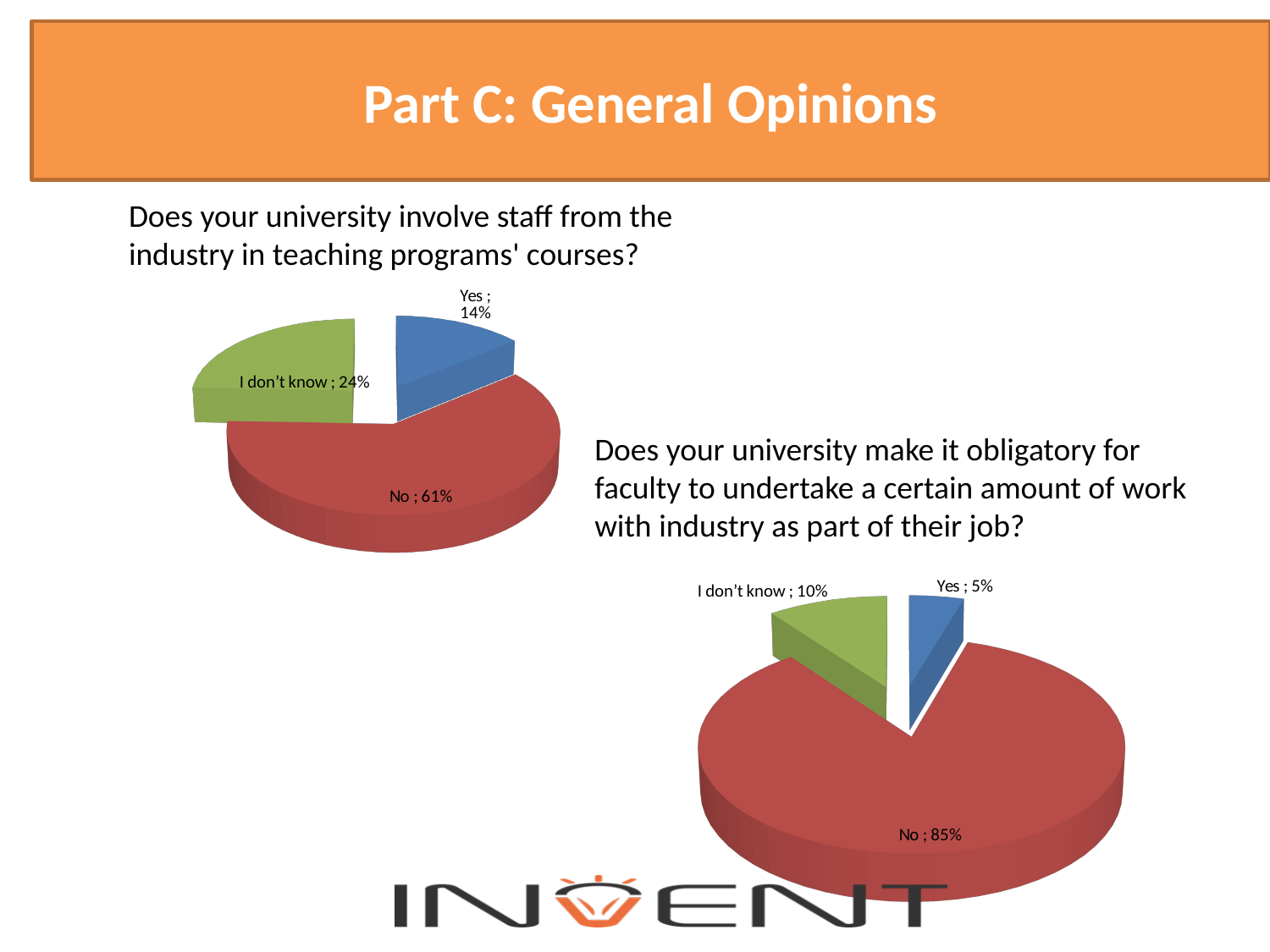
What type of chart is used for the question about obligatory work with industry? Pie chart In the pie chart about obligatory work with industry, what percentage answered "I don't know"? 10% In the pie chart about obligatory work with industry, what percentage answered "Yes"? 5% Which chart has the larger "No" share: the one about involving industry staff in teaching or the one about obligatory work with industry? The one about obligatory work with industry In the pie chart about involving industry staff in teaching programs' courses, what is the difference between the "I don't know" and "Yes" shares? 10% In the pie chart about obligatory work with industry, what is the difference between the "No" and "I don't know" shares? 75% In the pie chart about involving industry staff in teaching programs' courses, what percentage answered "I don't know"? 24% In the pie chart about involving industry staff in teaching programs' courses, what percentage answered "No"? 61% In the pie chart about obligatory work with industry, which response has the smallest share? Yes In the pie chart about involving industry staff in teaching programs' courses, what percentage answered "Yes"? 14% In the pie chart about obligatory work with industry, what percentage answered "No"? 85% In the pie chart about involving industry staff in teaching programs' courses, which response has the largest share? No